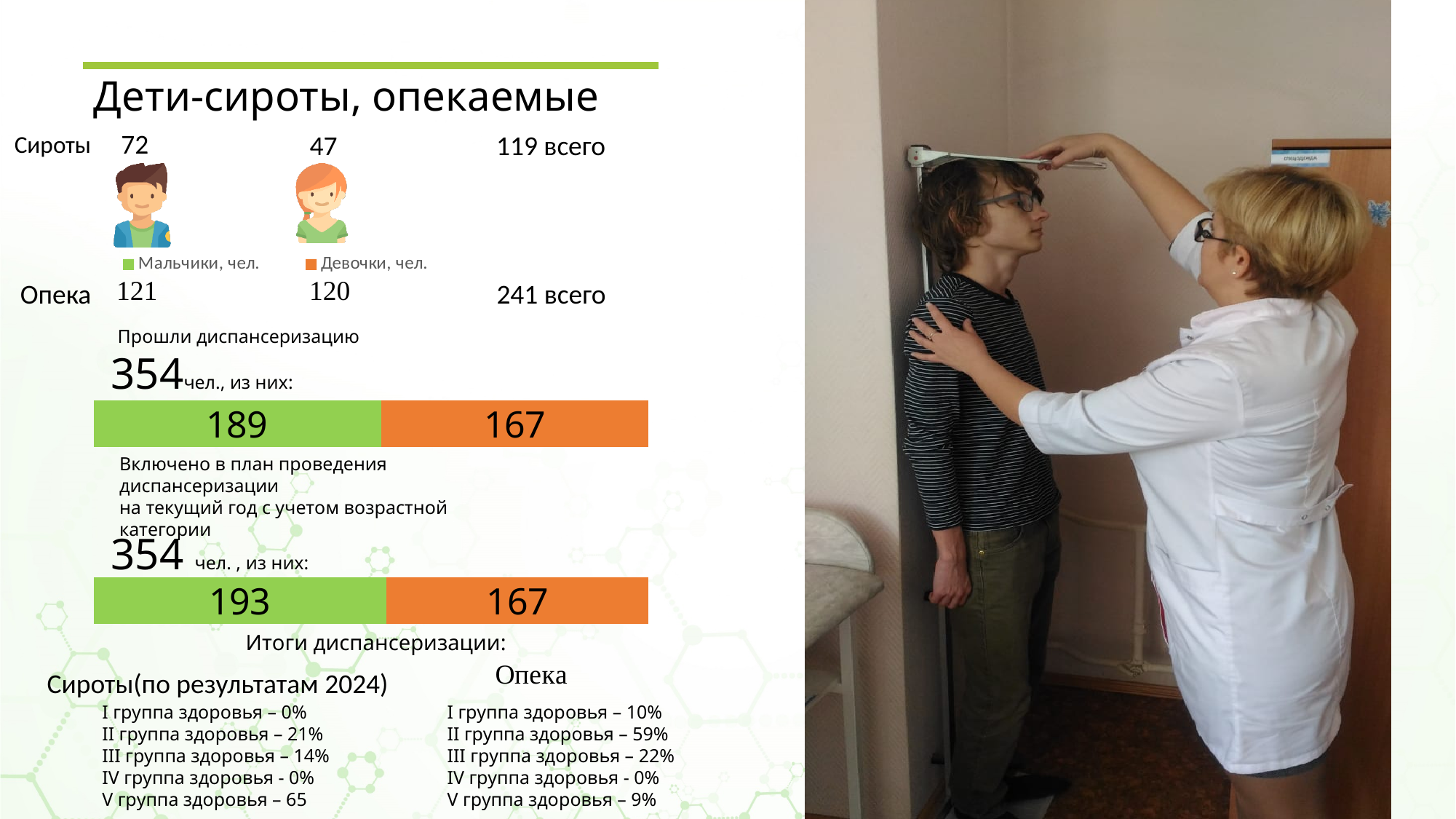
What is the difference between the Мальчики value in the 'Включено в план' bar chart and the Мальчики value in the 'Прошли диспансеризацию' bar chart? 4 In the bar chart under 'Включено в план проведения диспансеризации', what is the value for Девочки, чел.? 167 In the bar chart under 'Прошли диспансеризацию', what is the value for Мальчики, чел.? 189 In the bar chart under 'Прошли диспансеризацию', what is the difference between the Мальчики and Девочки values? 22 How many series does the legend with 'Мальчики, чел.' and 'Девочки, чел.' list? 2 In the bar chart under 'Прошли диспансеризацию', which segment is larger, Мальчики or Девочки? Мальчики In the bar chart under 'Прошли диспансеризацию', what is the value for Девочки, чел.? 167 What colour represents Мальчики, чел. in the bar charts? Green Which bar chart has the larger Мальчики value: the one under 'Прошли диспансеризацию' or the one under 'Включено в план проведения диспансеризации'? Включено в план проведения диспансеризации In the bar chart under 'Включено в план проведения диспансеризации', what is the difference between the Мальчики and Девочки values? 26 What kind of chart is used to show the 189 and 167 values under 'Прошли диспансеризацию'? Bar chart In the bar chart under 'Включено в план проведения диспансеризации', what is the value for Мальчики, чел.? 193